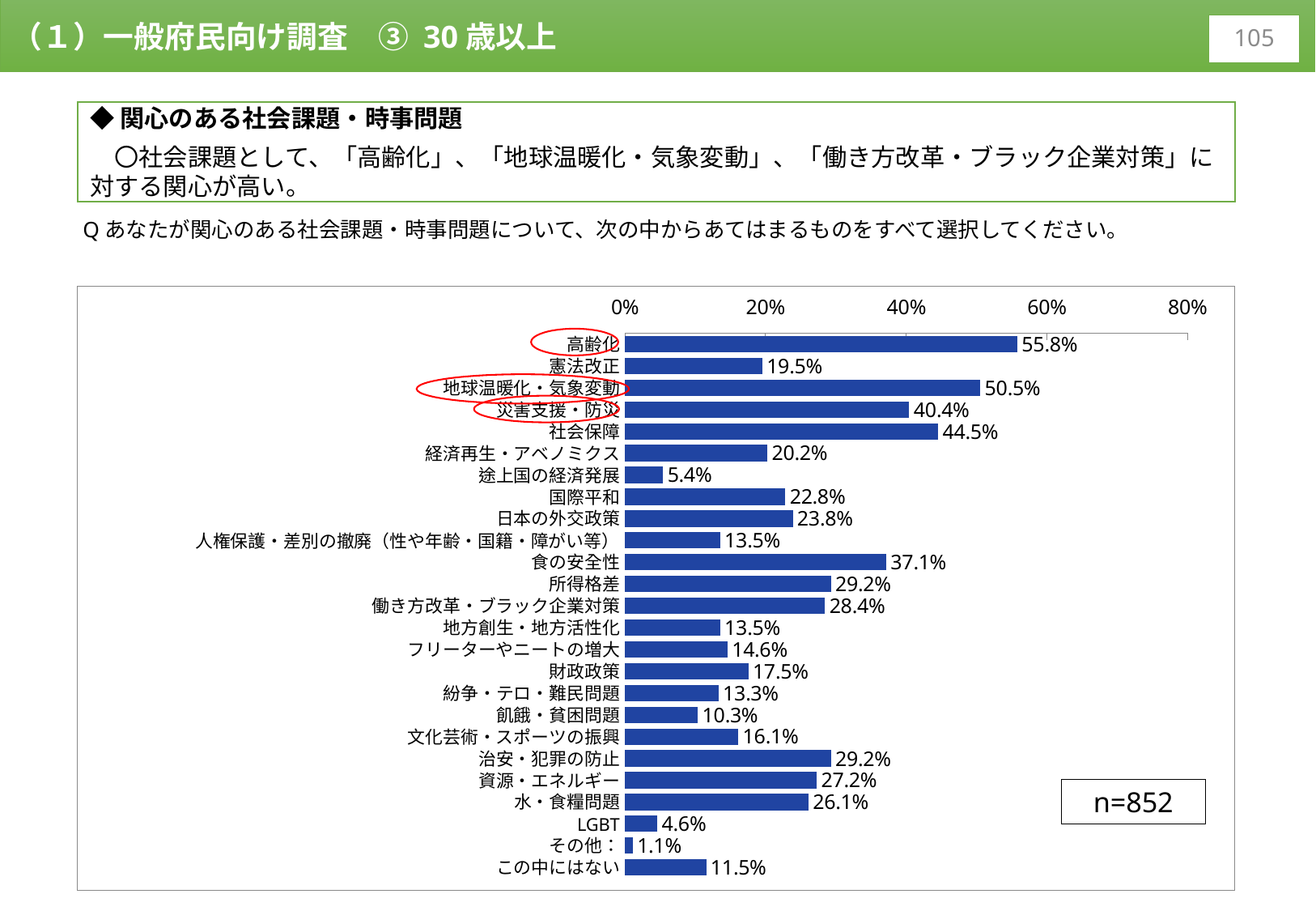
What is the sample size (n) shown on the chart? n=852 Which category has the lowest value? その他 Which is larger, the value for 社会保障 or the value for 災害支援・防災? 社会保障 What kind of chart is shown on the slide? bar chart Which category has the highest value? 高齢化 What is the value for 働き方改革・ブラック企業対策? 28.4% What is the value for 地球温暖化・気象変動? 50.5% How many categories are shown in the chart? 25 What is the value for LGBT? 4.6% Is the value for 食の安全性 greater or less than 40%? less What is the difference between the values for 高齢化 and 地球温暖化・気象変動? 5.3% What is the value for 高齢化? 55.8%